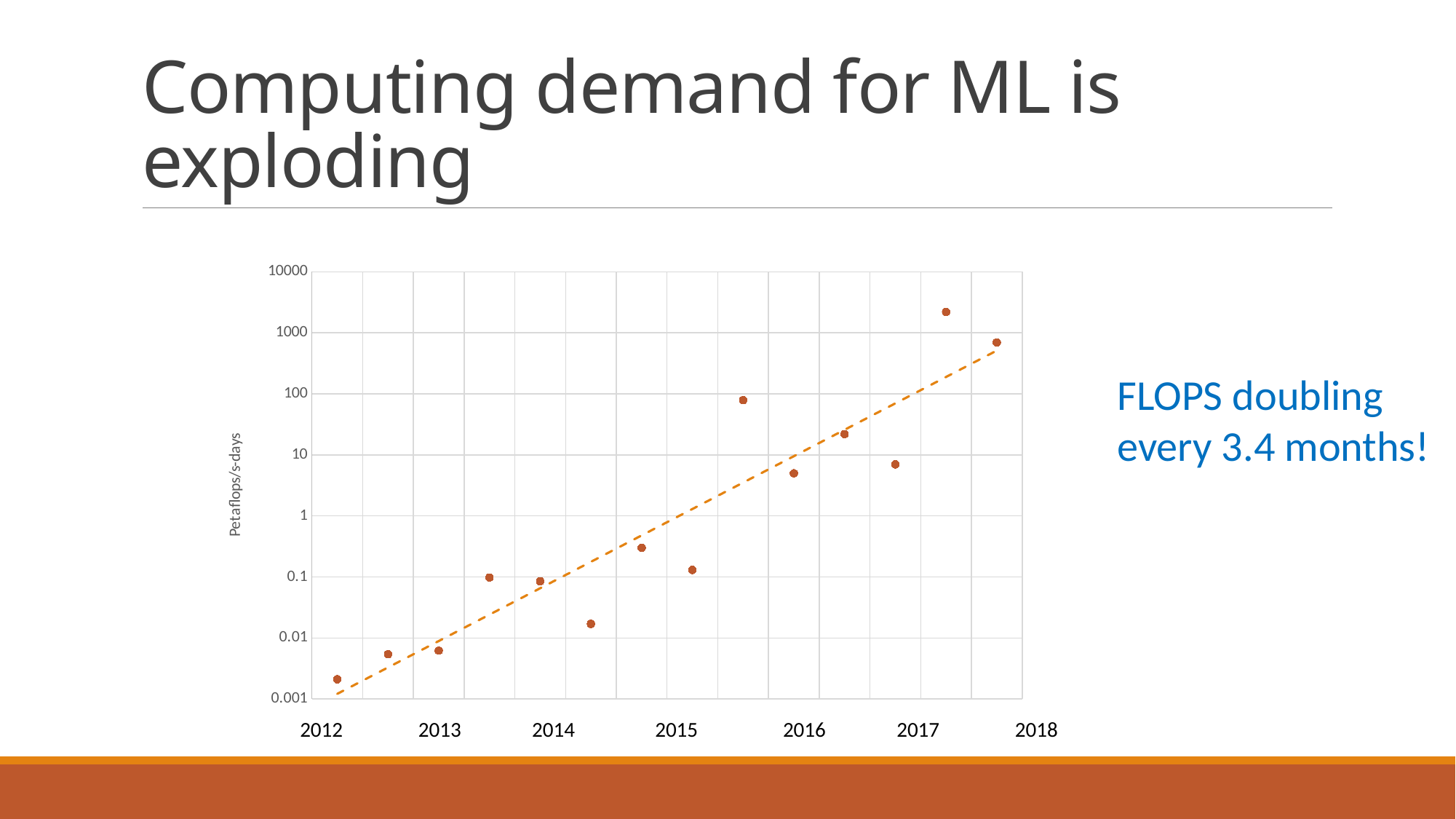
Do the plotted values generally rise or fall from 2012 to 2018? rise Which is larger: the point plotted just after 2017 or the point plotted just before 2018? the point just after 2017 What is the highest tick value shown on the y axis? 10000 Which is larger: the first point near 2012 or the point plotted just after 2013? the point just after 2013 How many data points are plotted on the chart? 14 Is the value of the highest plotted point (just after 2017) greater or less than 1000? greater What kind of chart is shown on the slide? scatter chart Is the value of the first plotted point (near 2012) greater or less than 0.01? less Is the value of the higher point plotted between 2015 and 2016 greater or less than 10? greater What is the label on the y axis of the chart? Petaflops/s-days